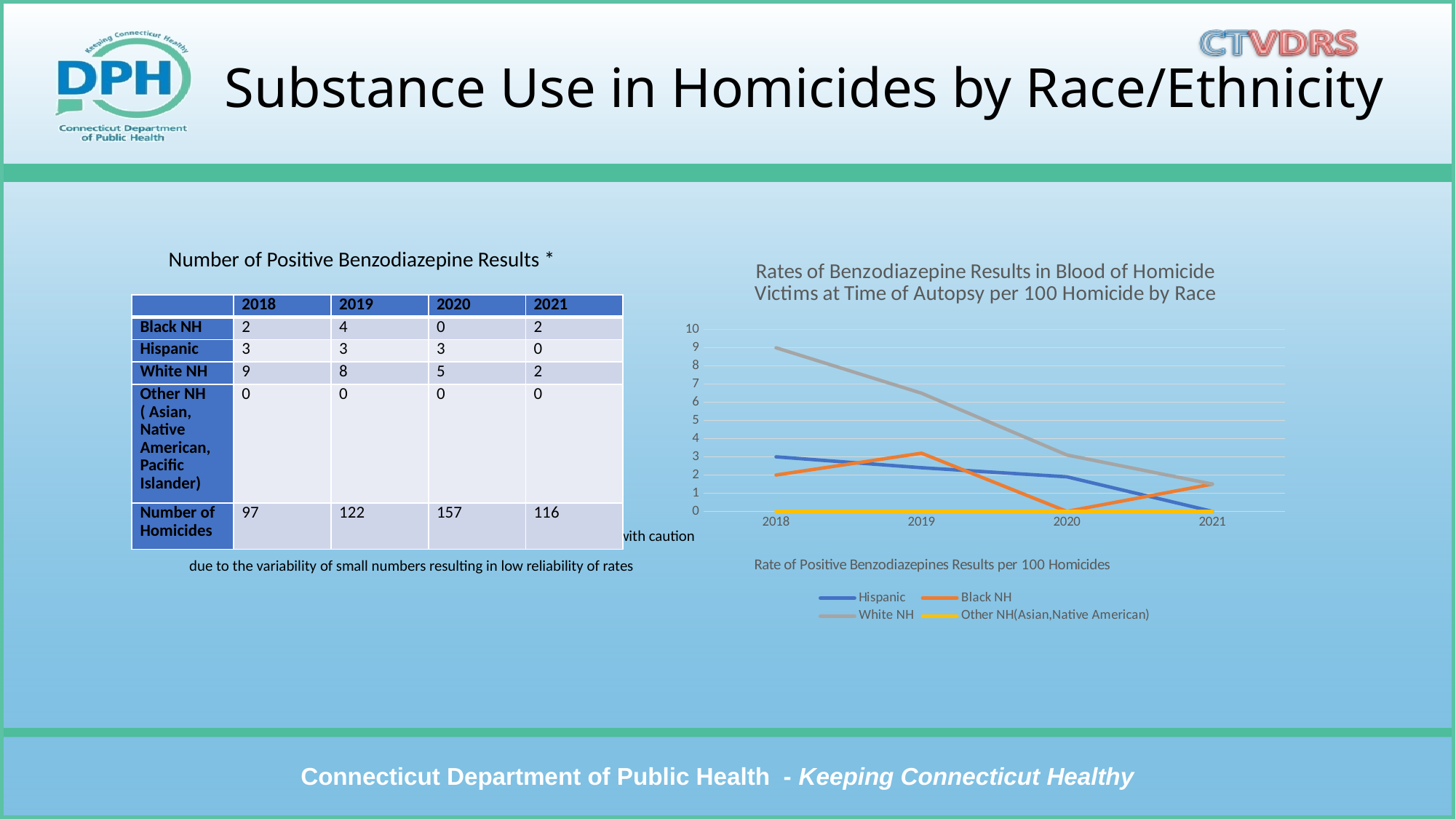
In the line chart, does the White NH rate rise or fall from 2018 to 2021? fall In the line chart, is the White NH rate in 2018 greater or less than 8? greater In the line chart, which is larger in 2019: the White NH rate or the Hispanic rate? White NH What kind of chart is shown on the right side of the slide? line chart What is the title of the line chart? Rates of Benzodiazepine Results in Blood of Homicide Victims at Time of Autopsy per 100 Homicide by Race How many years are shown on the x axis of the line chart? 4 In the line chart, is the White NH rate in 2020 greater or less than 4? less In the line chart, what is the Hispanic rate in 2021? 0 How many series does the legend of the line chart list? 4 In the line chart, which race/ethnicity group has the lowest rate in 2018? Other NH(Asian,Native American) In the line chart, what is the rate for Other NH(Asian,Native American) in 2021? 0 In the line chart, which race/ethnicity group has the highest rate in 2018? White NH